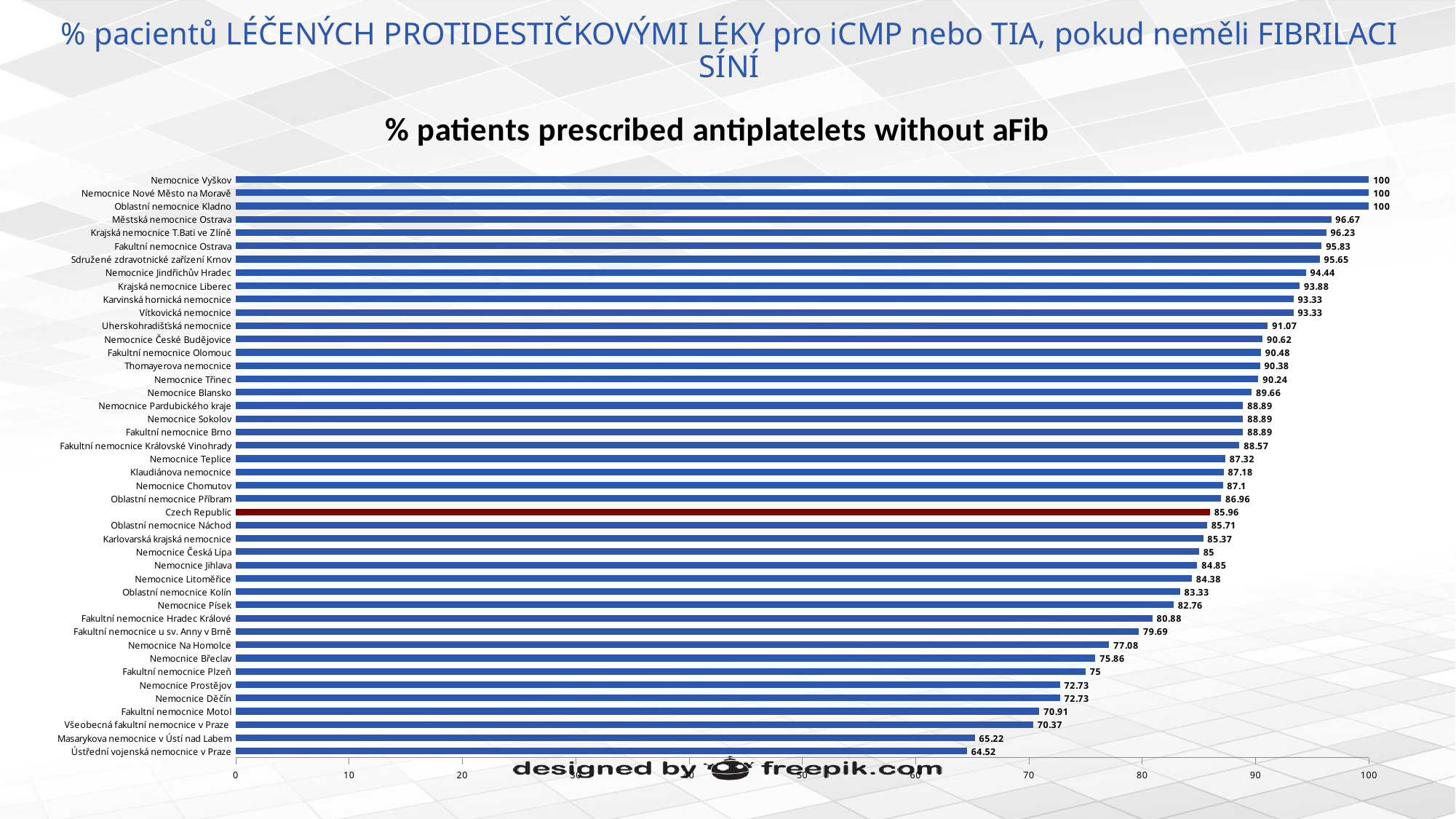
What kind of chart is shown? bar chart What is the highest value shown on the chart? 100 How many categories are plotted on the chart? 44 What is the value for Fakultní nemocnice Motol? 70.91 Which is larger, the value for Fakultní nemocnice Plzeň or the value for Nemocnice Prostějov? Fakultní nemocnice Plzeň Which category has the lowest value? Ústřední vojenská nemocnice v Praze Which bar is coloured differently (dark red) from the others? Czech Republic What is the value for Czech Republic? 85.96 What is the value for Nemocnice Třinec? 90.24 Is the value for Masarykova nemocnice v Ústí nad Labem greater or less than 70? less What is the difference between the values for Nemocnice Na Homolce and Nemocnice Břeclav? 1.22 What is the title of the chart? % patients prescribed antiplatelets without aFib